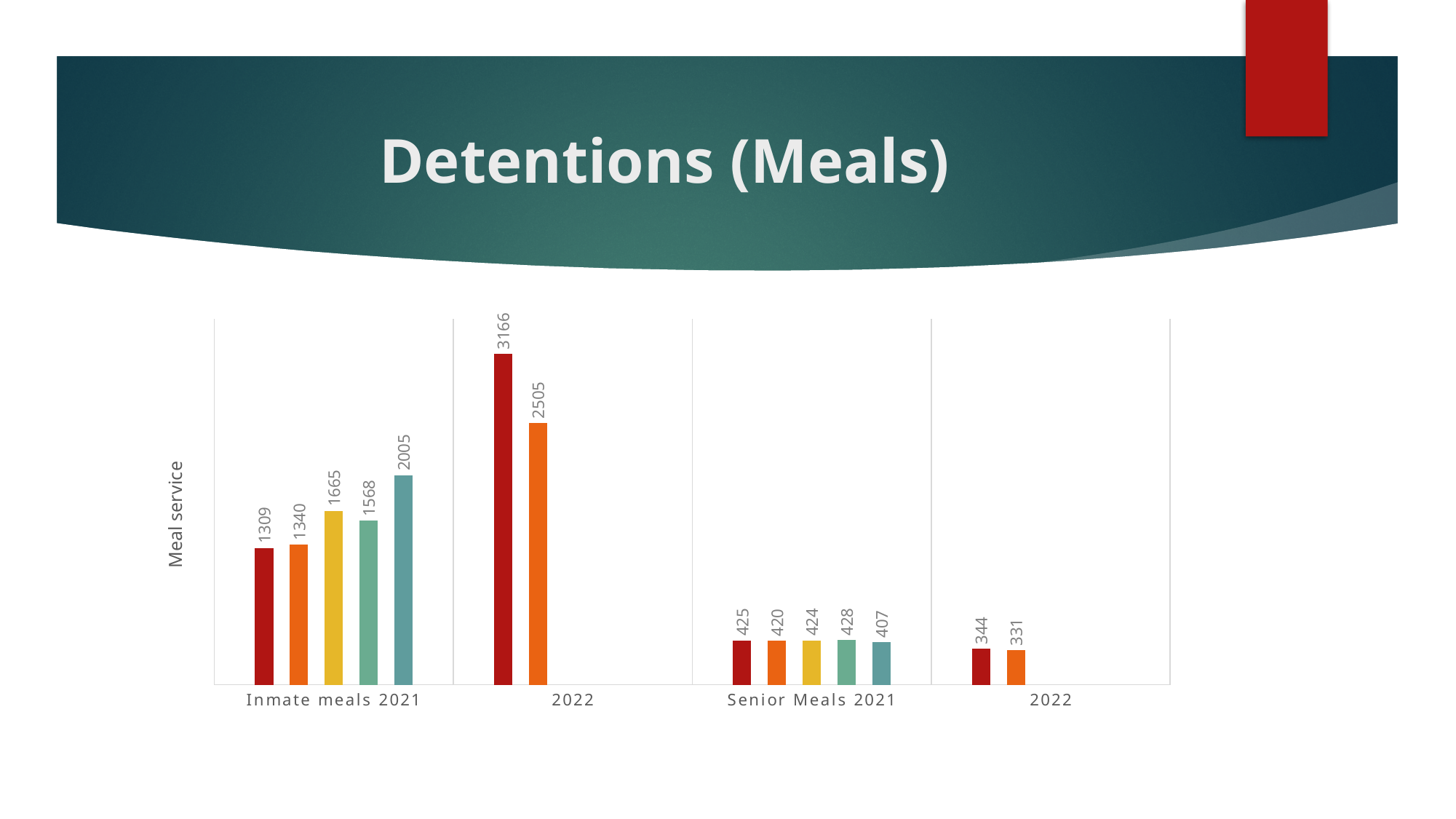
What is the value of the orange bar in the 2022 group next to Senior Meals 2021? 331 What is the label on the vertical axis of the chart? Meal service Which is larger: the red bar in Inmate meals 2021 or the red bar in the 2022 group beside it? the red bar in the 2022 group (3166) How many category groups are shown along the x axis? 4 What is the value of the last (teal) bar in the Inmate meals 2021 group? 2005 What is the value of the first (red) bar in the Inmate meals 2021 group? 1309 What is the difference between the two bars in the 2022 group next to Inmate meals 2021 (3166 and 2505)? 661 What is the lowest value shown in the Senior Meals 2021 group? 407 How many bars are in the Inmate meals 2021 group? 5 What is the value of the tallest bar in the 2022 group next to Inmate meals 2021? 3166 What is the difference between the red bar (344) and the orange bar (331) in the Senior Meals 2022 group? 13 What type of chart is shown on the slide? bar chart